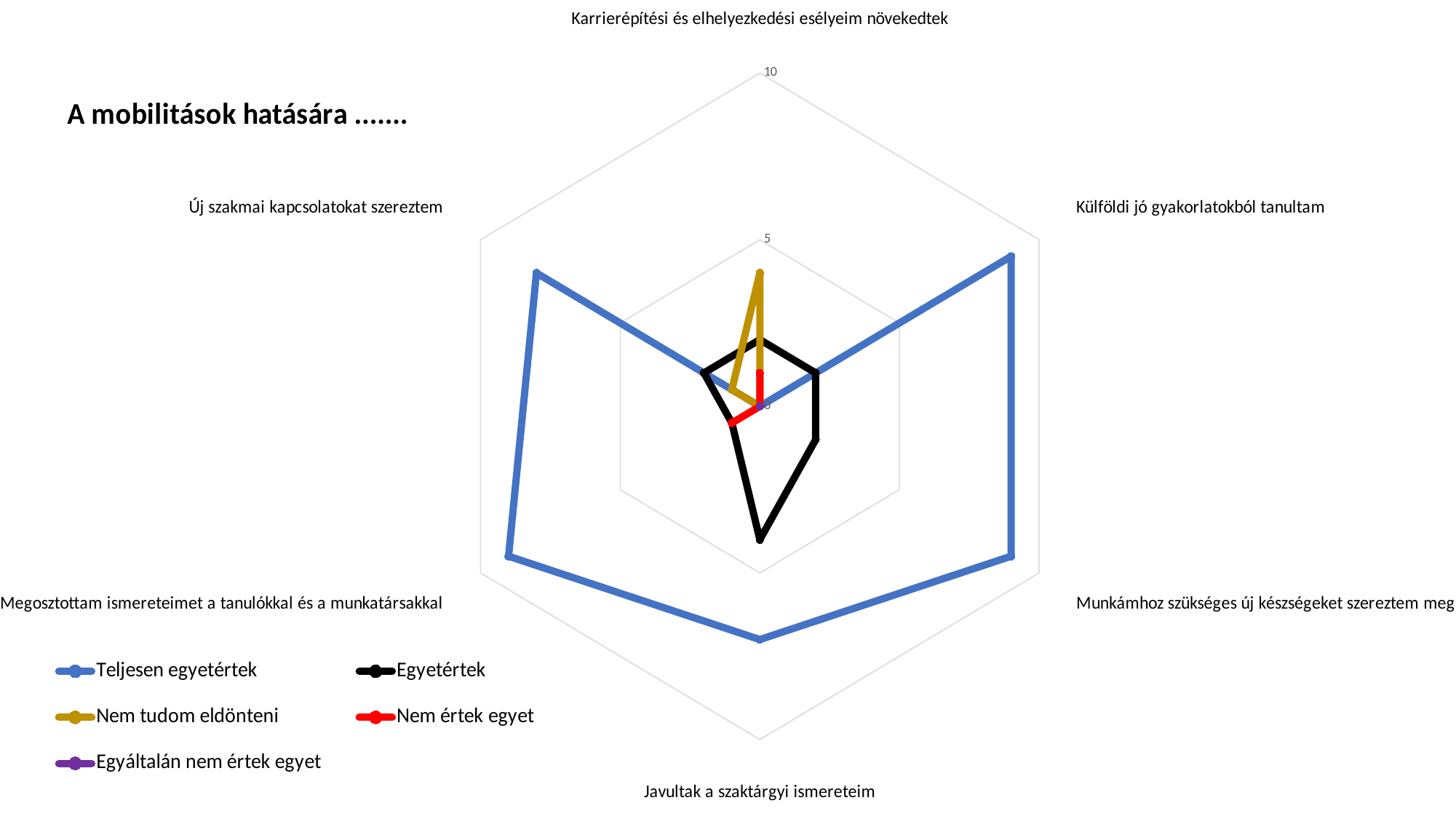
Is the value of 'Egyetértek' for 'Javultak a szaktárgyi ismereteim' greater or less than 5? less For which category is the 'Nem tudom eldönteni' value highest? Karrierépítési és elhelyezkedési esélyeim növekedtek Is the value of 'Nem tudom eldönteni' for 'Karrierépítési és elhelyezkedési esélyeim növekedtek' greater or less than 5? less For which category is the 'Teljesen egyetértek' value lowest? Karrierépítési és elhelyezkedési esélyeim növekedtek How many categories (axes) does the radar chart have? 6 For which category is the 'Egyetértek' value highest? Javultak a szaktárgyi ismereteim What is the title shown on the slide? A mobilitások hatására ....... What kind of chart is shown on the slide? Radar chart How many series does the legend list? 5 For 'Javultak a szaktárgyi ismereteim', which is larger: 'Teljesen egyetértek' or 'Egyetértek'? Teljesen egyetértek Is the value of 'Teljesen egyetértek' for 'Javultak a szaktárgyi ismereteim' greater or less than 5? greater